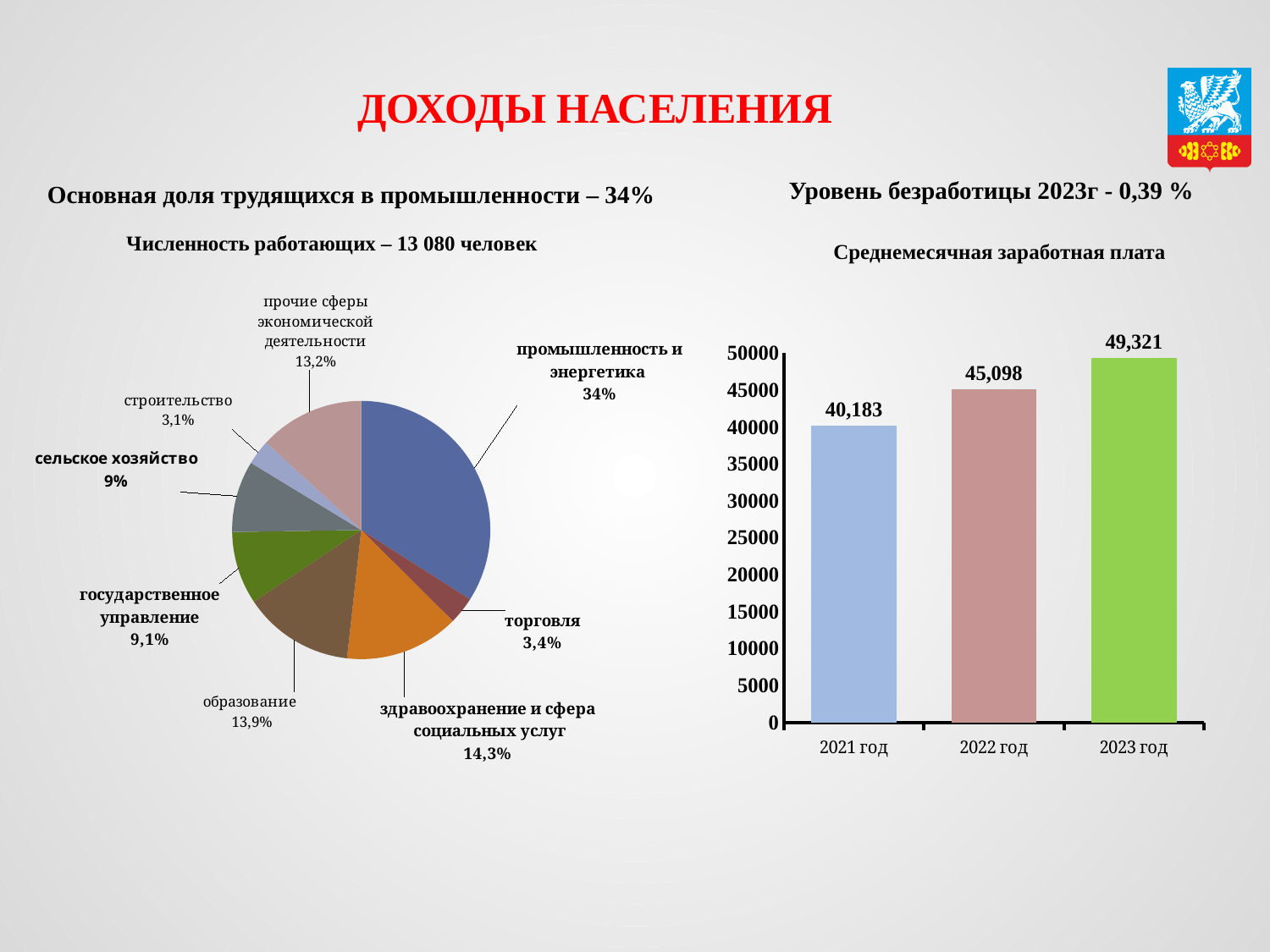
In the pie chart on the left, which sector has the largest share? промышленность и энергетика In the chart titled Среднемесячная заработная плата, what is the value for 2022 год? 45,098 In the pie chart on the left, what is the difference between the share of промышленность и энергетика and the share of строительство? 30,9% In the chart titled Среднемесячная заработная плата, how many bars are there? 3 In the pie chart on the left, which sector has the smallest share? строительство In the pie chart on the left, what share is shown for промышленность и энергетика? 34% What kind of chart is the chart titled Среднемесячная заработная плата? bar chart In the chart titled Среднемесячная заработная плата, do the values rise or fall from 2021 год to 2023 год? rise In the pie chart on the left, how many slices are there? 8 In the pie chart on the left, which is larger: the share of здравоохранение и сфера социальных услуг or the share of государственное управление? здравоохранение и сфера социальных услуг In the chart titled Среднемесячная заработная плата, what is the difference between the values for 2023 год and 2021 год? 9,138 In the pie chart on the left, what share is shown for образование? 13,9%